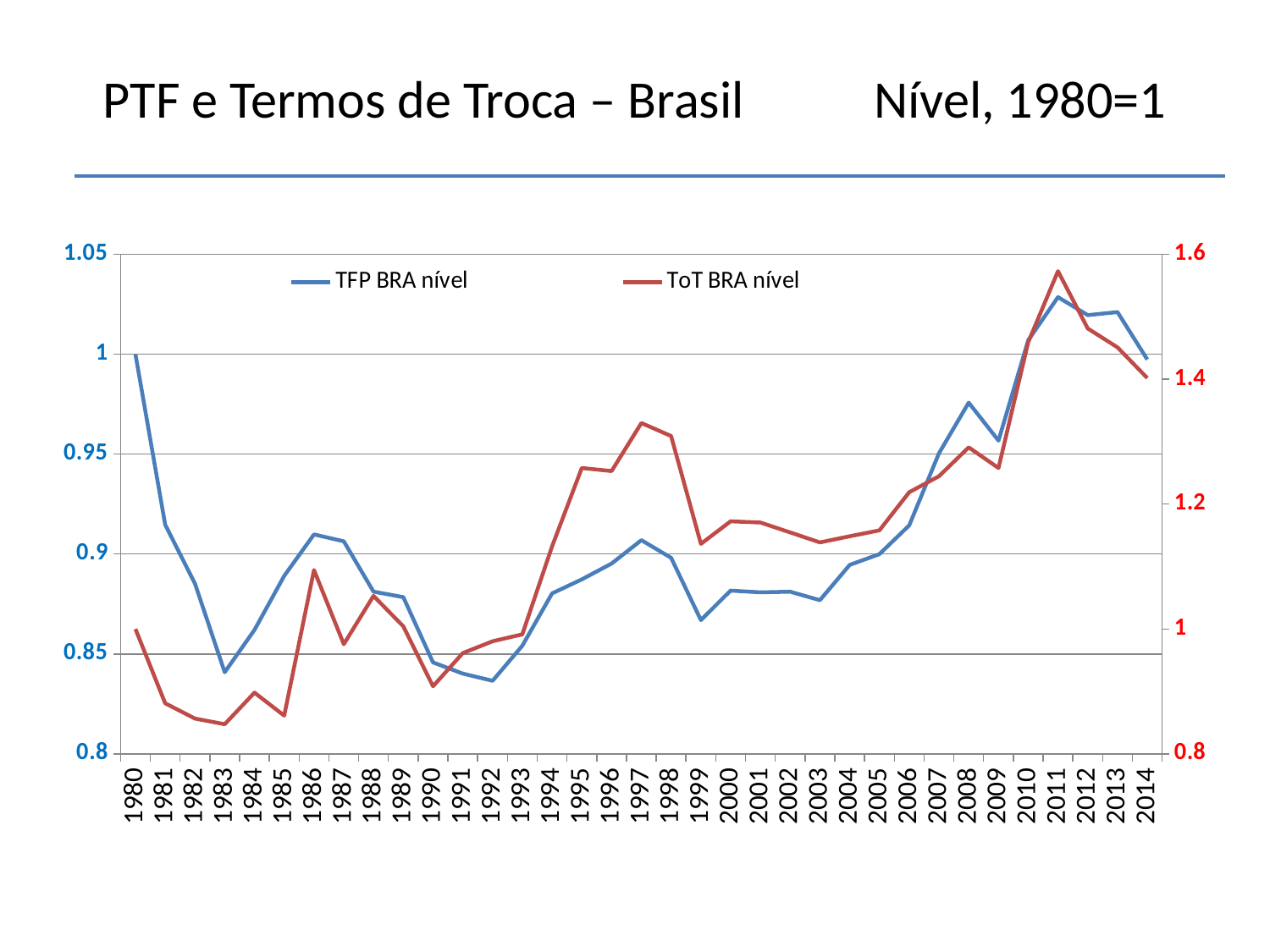
Is the value for TFP BRA nível in 1983 greater or less than 0.85? less Is the value for ToT BRA nível in 2003 greater or less than 1.2? less In which year does TFP BRA nível reach its highest value? 2011 How many years are plotted along the x axis? 35 Is the value for ToT BRA nível in 1997 greater or less than 1.2? greater How many series does the legend list? 2 What is the value of TFP BRA nível in 1980? 1 In which year does ToT BRA nível reach its highest value? 2011 Does TFP BRA nível rise or fall from 1980 to 1983? fall Which is larger for TFP BRA nível: the value in 1986 or the value in 1990? 1986 What kind of chart is shown on the slide? line chart